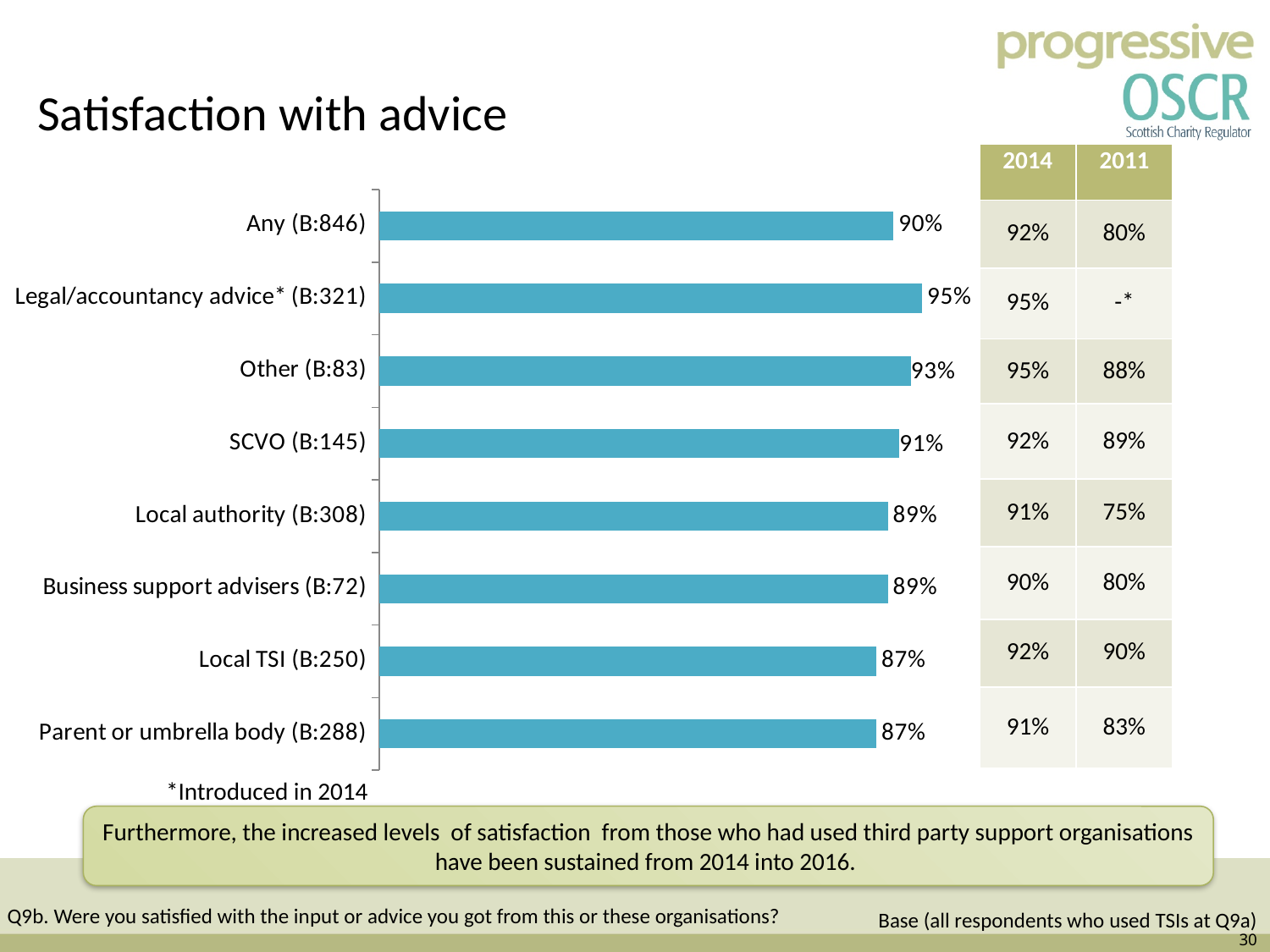
What is the value shown for Local TSI (B:250)? 87% Which category has the highest satisfaction value in the chart? Legal/accountancy advice* (B:321) What is the value shown for Other (B:83)? 93% What is the difference between the values for Legal/accountancy advice* (B:321) and Parent or umbrella body (B:288)? 8% What is the value shown for Legal/accountancy advice* (B:321)? 95% How many categories are shown in the bar chart? 8 What is the difference between the values for Other (B:83) and Local authority (B:308)? 4% Which is larger, the value for SCVO (B:145) or the value for Local TSI (B:250)? SCVO (B:145) What type of chart is shown on the slide? Bar chart What is the value shown for SCVO (B:145)? 91% What is the title of the slide containing the chart? Satisfaction with advice What is the satisfaction value shown for Any (B:846)? 90%